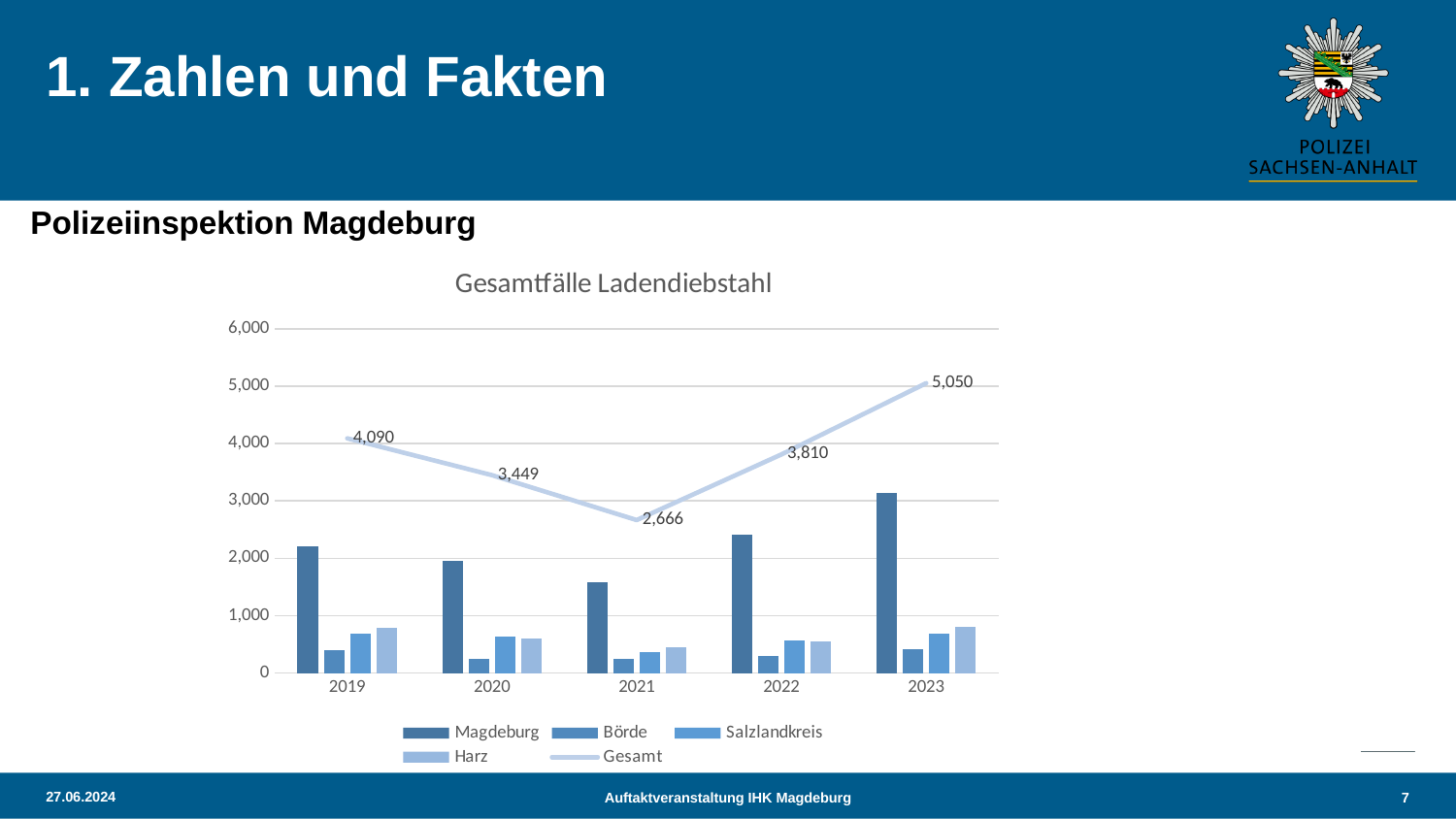
What is the difference between the Gesamt values for 2022 and 2021? 1,144 In which year is the Gesamt value highest? 2023 What is the value of the Gesamt line for 2021? 2,666 What is the value of the Gesamt line for 2023? 5,050 What is the difference between the Gesamt values for 2023 and 2019? 960 How many years are shown on the x axis? 5 In which year is the Gesamt value lowest? 2021 Which year has the larger Gesamt value, 2020 or 2022? 2022 What is the value of the Gesamt line for 2020? 3,449 How many series does the legend list? 5 Is the value for Magdeburg in 2021 greater or less than 2,000? less Is the value for Magdeburg in 2023 greater or less than 3,000? greater